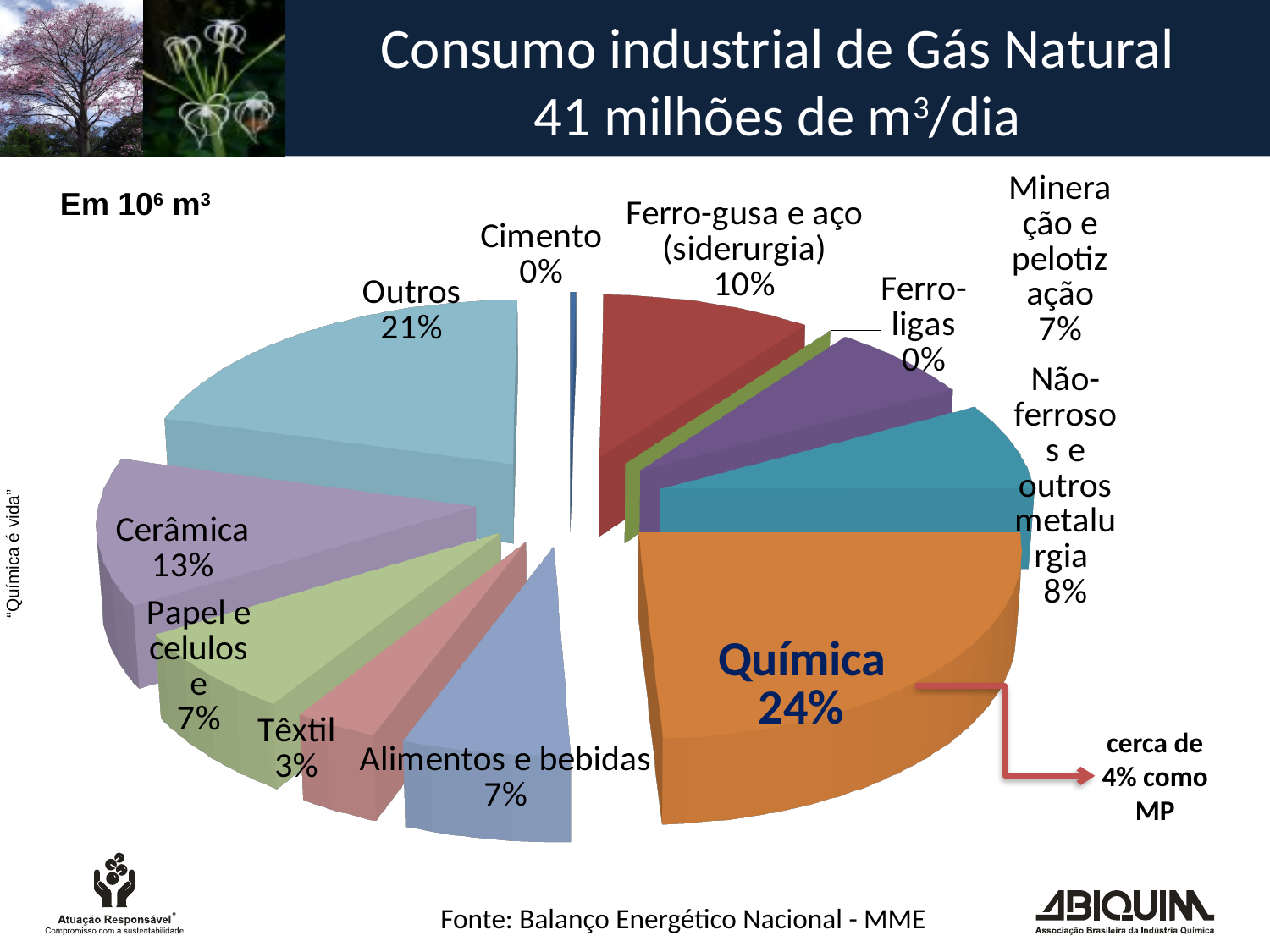
What percentage is shown for Ferro-gusa e aço (siderurgia)? 10% What percentage is shown for Outros? 21% What is the difference in percentage points between Cerâmica and Têxtil? 10% Which is larger, the share for Cerâmica or the share for Não-ferrosos e outros metalurgia? Cerâmica What is the difference in percentage points between Química and Outros? 3% How many sectors (slices) are labelled in the pie chart? 11 Which sector has the largest share of the pie? Química What is the title of the chart on the slide? Consumo industrial de Gás Natural 41 milhões de m³/dia What percentage is shown for Cerâmica? 13% What percentage is shown for Têxtil? 3% What share of industrial natural gas consumption does Química account for? 24% What kind of chart is shown on the slide? Pie chart